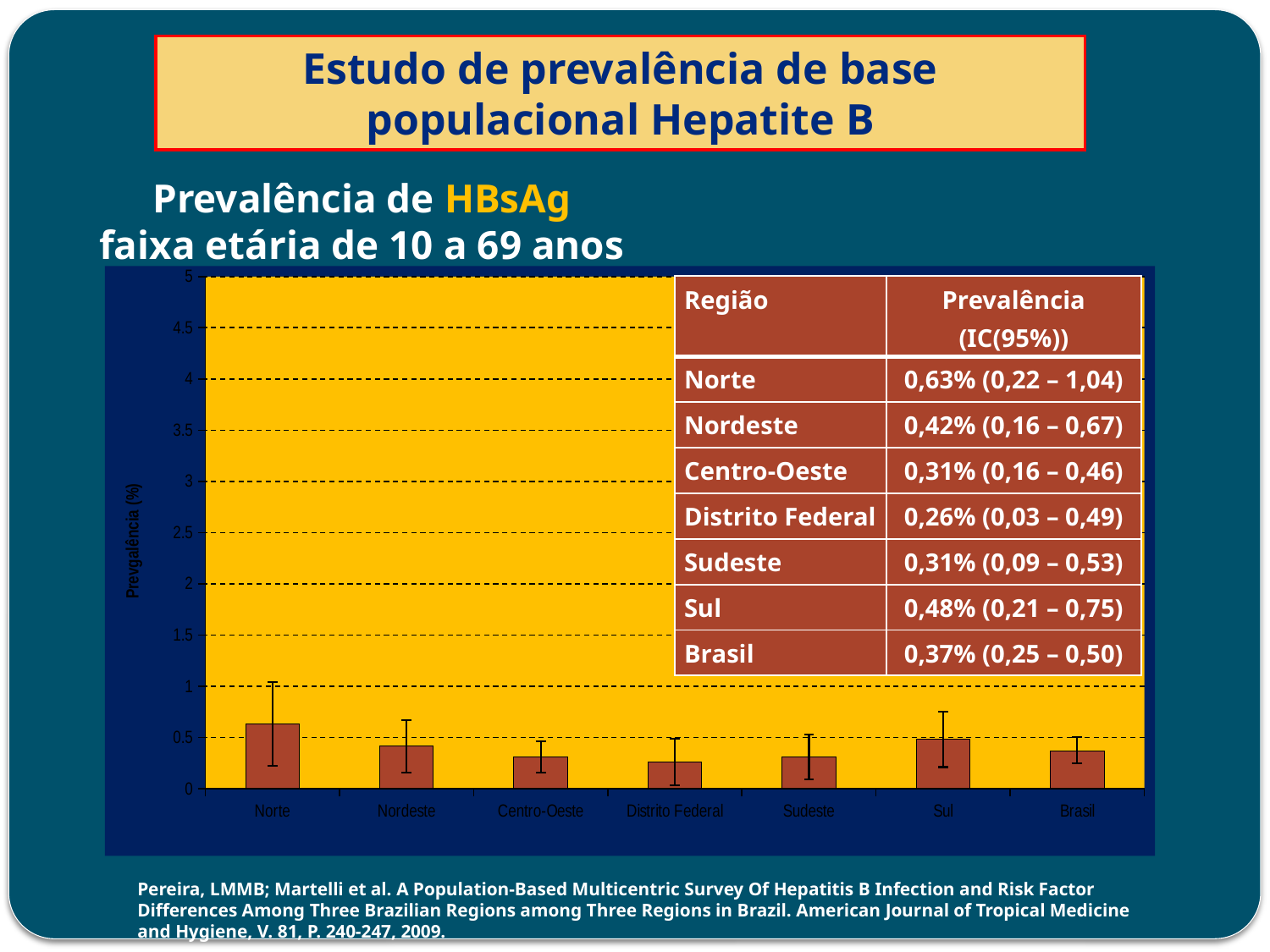
Which has a higher prevalence, Sul or Nordeste? Sul Is the value for Norte greater or less than 0.5? greater What is the prevalence value shown for Norte? 0,63% Which region has the highest prevalence in the chart? Norte What is the prevalence value shown for Sul? 0,48% How many regions (bars) are shown in the chart? 7 Which region has the lowest prevalence in the chart? Distrito Federal What is the difference between the prevalence for Norte and for Nordeste? 0,21 percentage points What is the label of the vertical axis of the chart? Prevgalência (%) What is the prevalence value shown for Distrito Federal? 0,26% What kind of chart is shown on the slide? Bar chart What is the prevalence value shown for Brasil? 0,37%